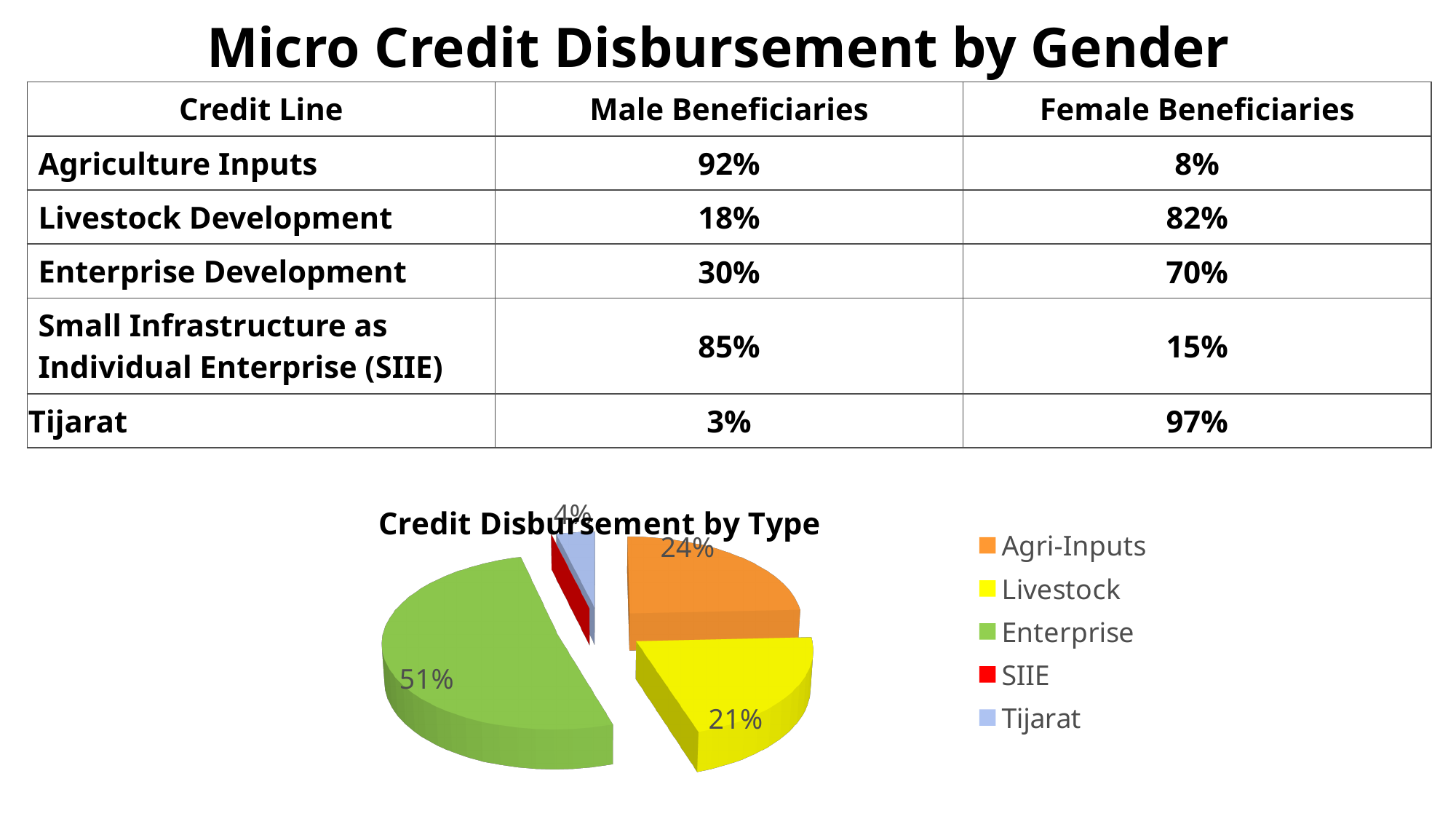
In the "Credit Disbursement by Type" pie chart, what share does Livestock have? 21% In the "Credit Disbursement by Type" pie chart, which category has the largest slice? Enterprise In the "Credit Disbursement by Type" pie chart, is the Enterprise share greater or less than 50%? greater In the "Credit Disbursement by Type" pie chart, what is the difference between the Enterprise share and the Agri-Inputs share? 27% How many categories does the legend of the "Credit Disbursement by Type" pie chart list? 5 What type of chart is "Credit Disbursement by Type"? pie chart In the "Credit Disbursement by Type" pie chart, what share does Agri-Inputs have? 24% In the "Credit Disbursement by Type" pie chart, which category is shown in red? SIIE In the "Credit Disbursement by Type" pie chart, what is the difference between the Agri-Inputs share and the Livestock share? 3% In the "Credit Disbursement by Type" pie chart, what share does Enterprise have? 51% In the "Credit Disbursement by Type" pie chart, which category is shown in green? Enterprise In the "Credit Disbursement by Type" pie chart, which is larger, Agri-Inputs or Livestock? Agri-Inputs